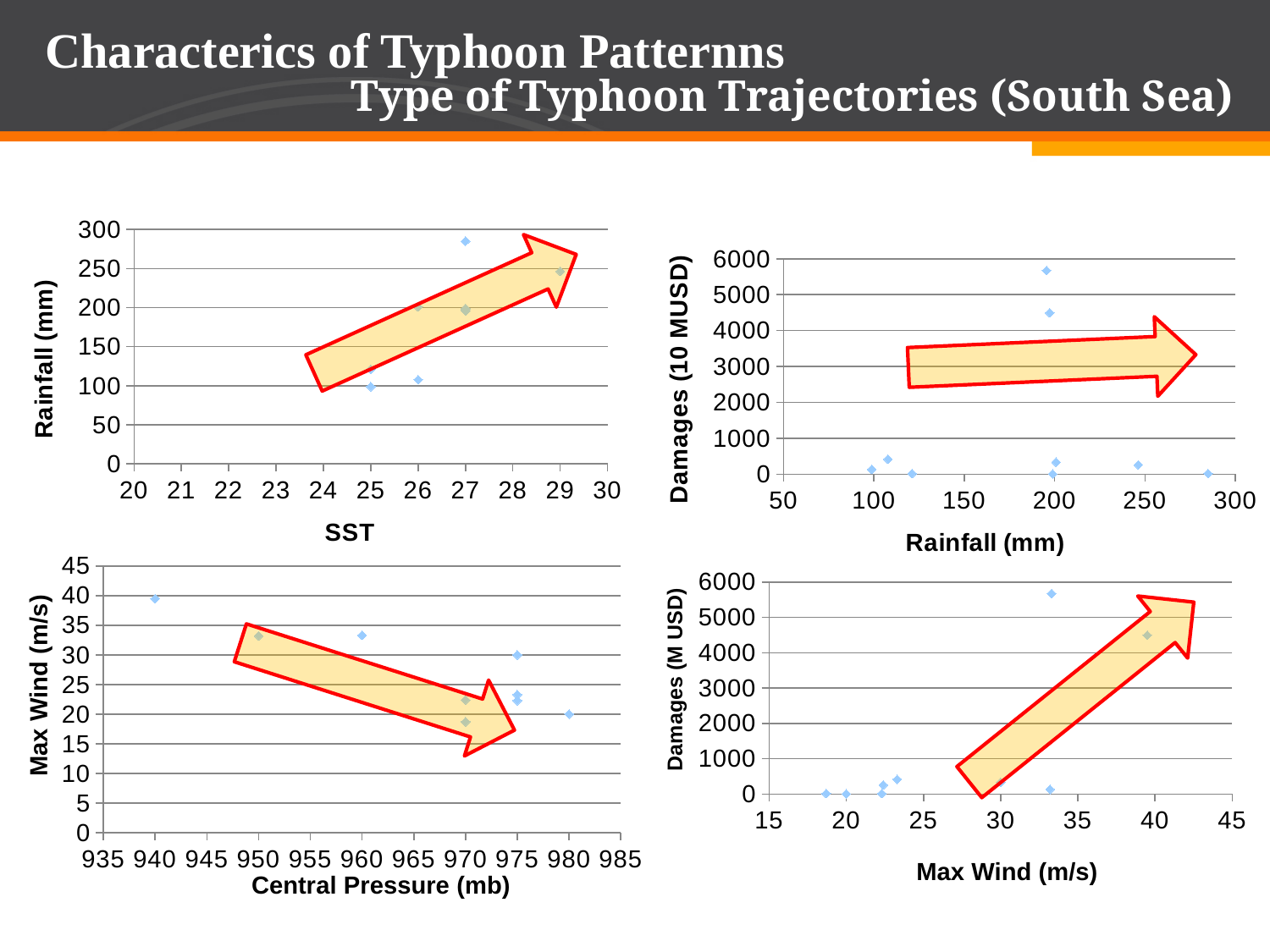
How many charts are shown on the slide? 4 In the top-left chart, what is the label of the x axis? SST In the bottom-left chart, what is the label of the y axis? Max Wind (m/s) What kind of chart is the top-left chart (Rainfall vs SST)? scatter chart In the bottom-left chart (Max Wind vs Central Pressure), do the max wind values generally rise or fall as central pressure increases? fall In the bottom-right chart, is the highest damages value greater or less than 5000? greater In the bottom-right chart (Damages vs Max Wind), do the damage values generally rise or fall as max wind increases? rise In the top-left chart, is the rainfall value for the point at SST 29 greater or less than 200? greater In the bottom-left chart, is the max wind value for the point at central pressure 940 greater or less than 35? greater In the top-left chart (Rainfall vs SST), do the rainfall values generally rise or fall as SST increases? rise